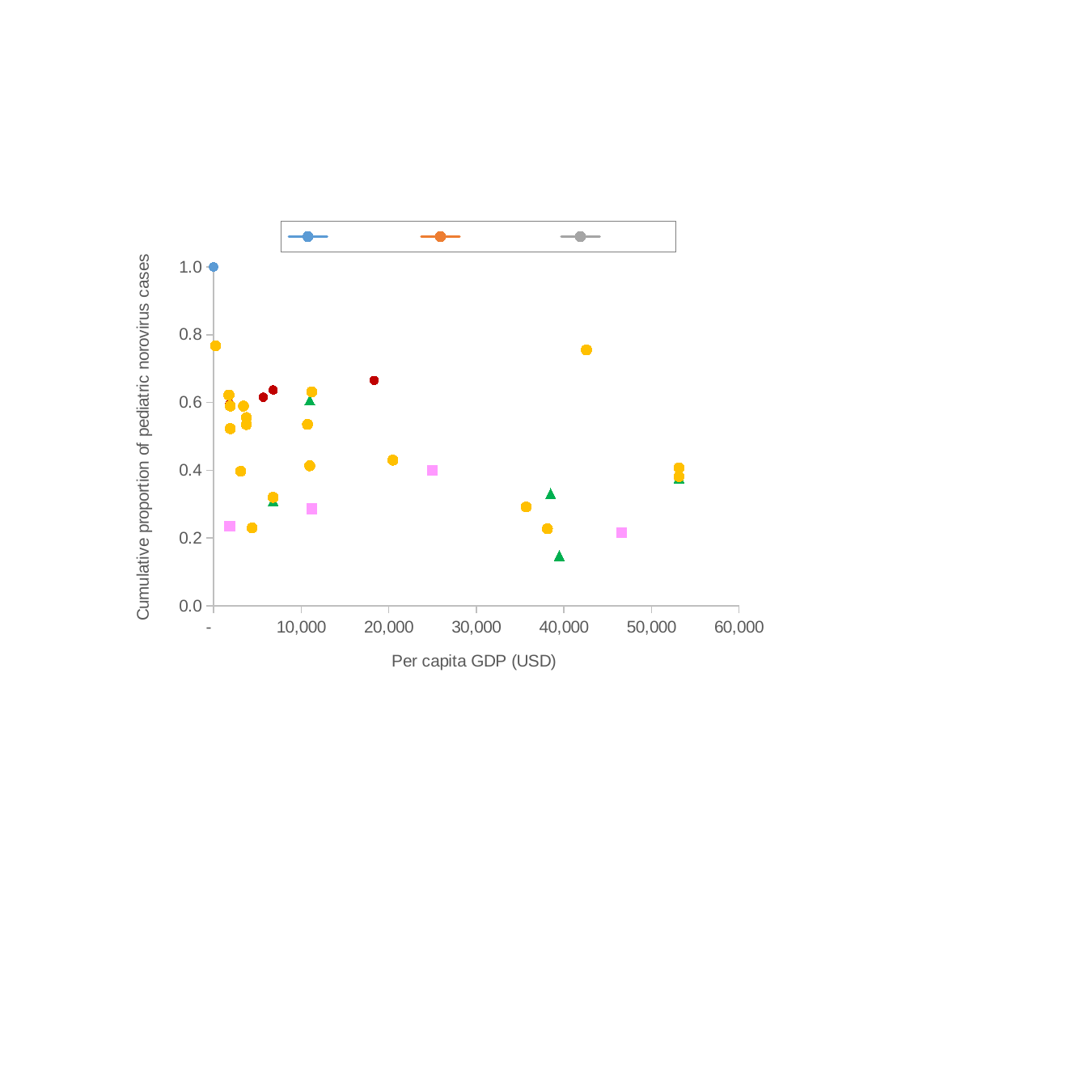
Is the y value of the pink square near 25,000 on the x axis greater or less than 0.6? less What is the title of the x axis? Per capita GDP (USD) Is the y value of the dark red point near 18,000 on the x axis greater or less than 0.6? greater What kind of chart is shown on the slide? scatter chart Is the y value of the lowest green triangle, near 39,000 on the x axis, greater or less than 0.2? less Which has the larger y value: the blue point at the far left or the yellow point near 42,000 on the x axis? the blue point at the far left What is the title of the y axis? Cumulative proportion of pediatric norovirus cases What is the highest y value reached by any point on the chart? 1.0 What is the y value of the blue point at the far left of the chart, at the top of the y axis? 1.0 What is the largest value labelled on the x axis? 60,000 How many entries does the legend show? 3